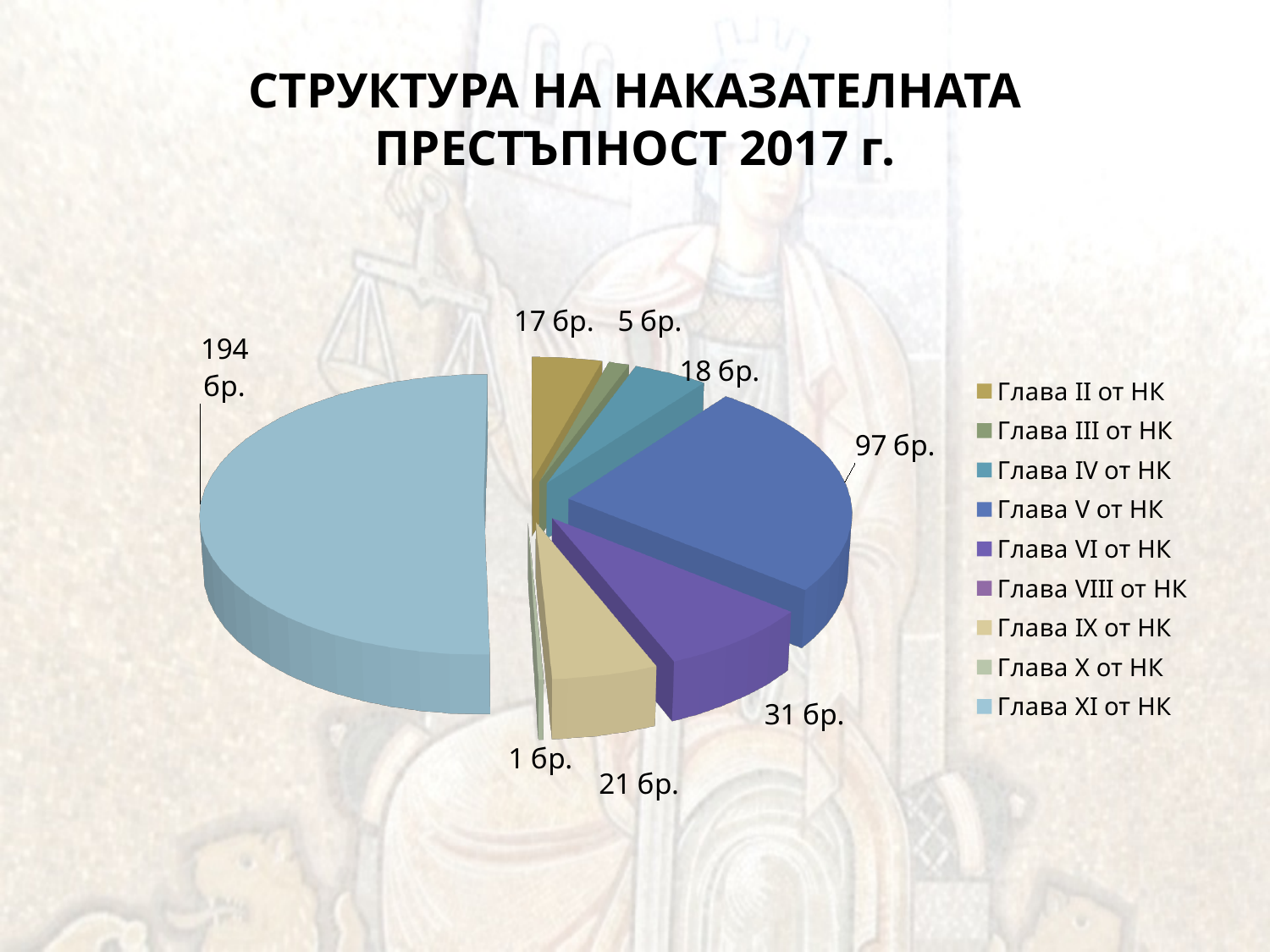
What value is shown for Глава III от НК? 5 бр. What value is shown for Глава X от НК? 1 бр. What value is shown for Глава IX от НК? 21 бр. What value is shown for Глава XI от НК? 194 бр. What value is shown for Глава IV от НК? 18 бр. What value is shown for Глава V от НК? 97 бр. What value is shown for Глава II от НК? 17 бр. What is the title of the chart on the slide? СТРУКТУРА НА НАКАЗАТЕЛНАТА ПРЕСТЪПНОСТ 2017 г. What kind of chart is shown on the slide? pie chart How many entries does the legend of the pie chart list? 9 Which category has the largest slice of the pie? Глава XI от НК What is the difference between the values for Глава XI от НК and Глава V от НК? 97 бр.